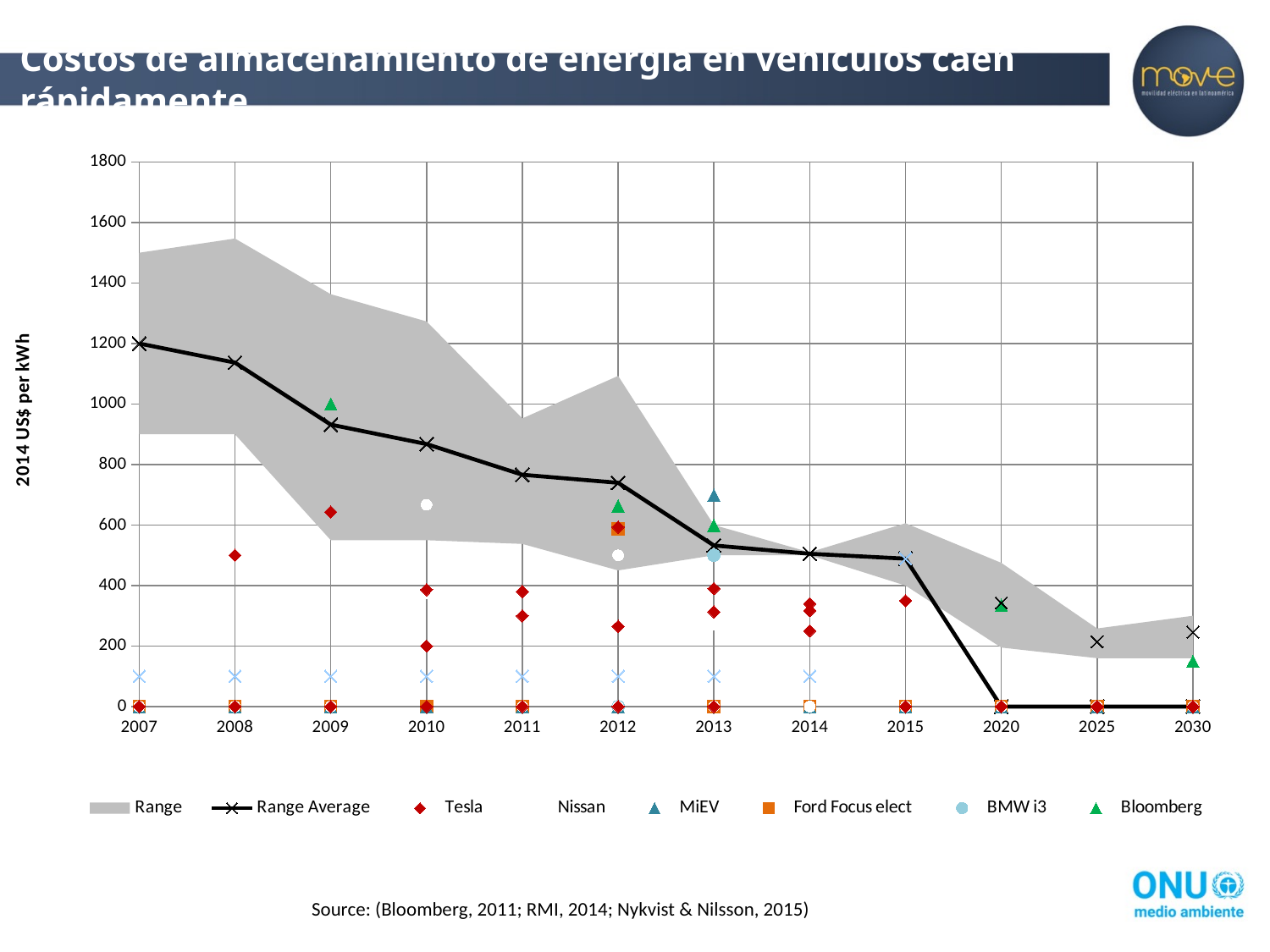
Is the Range Average value for 2012 greater or less than 800? less Is the Range Average value for 2030 greater or less than 400? less Is the Range Average value for 2007 greater or less than 1000? greater In which year is the Range Average value highest? 2007 How many years are shown on the x axis? 12 Does the Range Average line rise or fall from 2007 to 2030? fall Which series is shown as a grey shaded area? Range What kind of chart is used for the Range Average series? line chart What is the label on the vertical axis? 2014 US$ per kWh Which is larger, the Bloomberg value for 2009 or the Bloomberg value for 2030? 2009 How many series does the legend list? 8